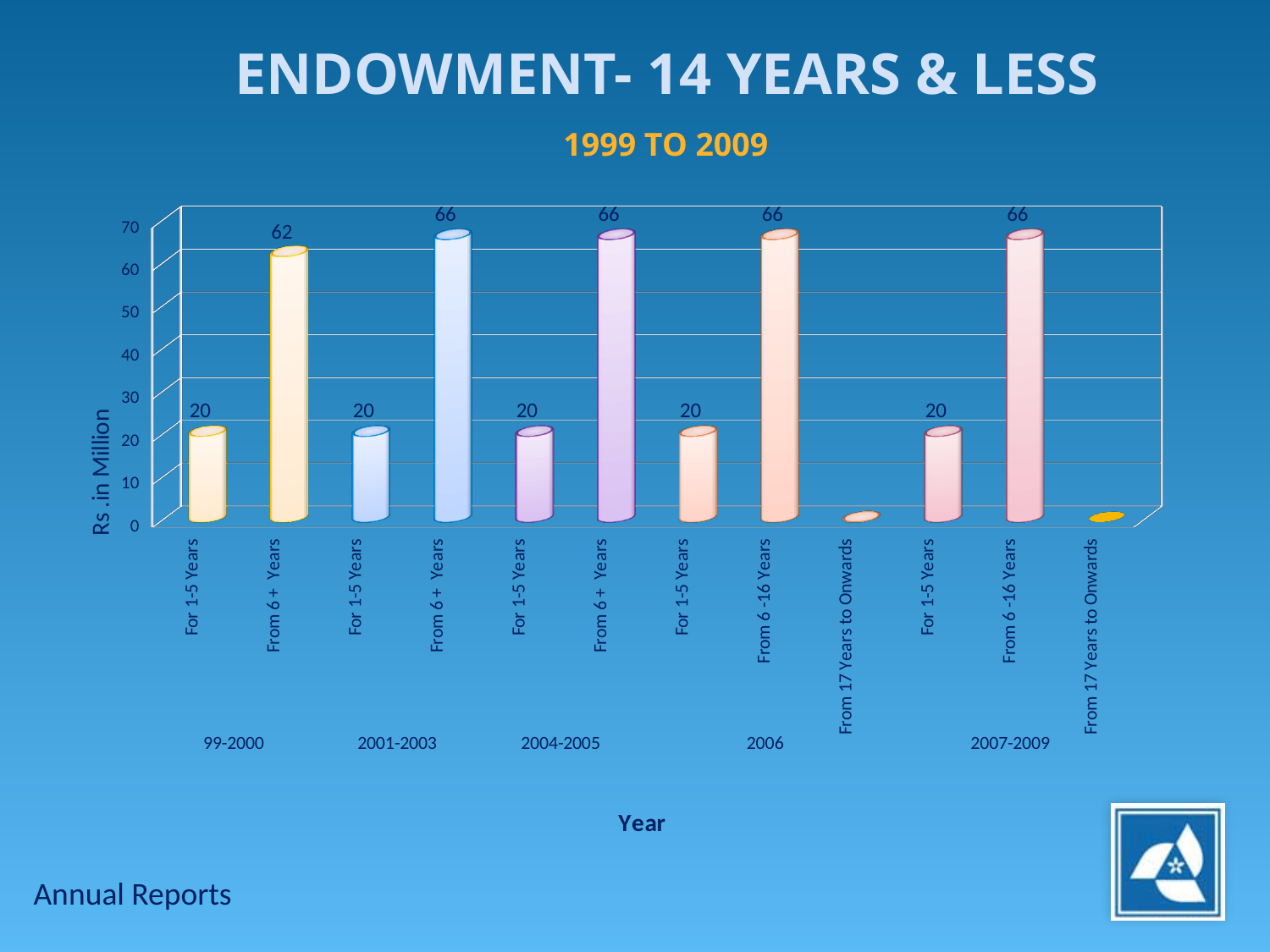
What is the value for 'For 1-5 Years' in 2001-2003? 20 How many bars are plotted on the chart? 12 What is the value for 'From 6 + Years' in 2004-2005? 66 Is the value for 'From 17 Years to Onwards' in 2006 greater or less than 10? less What is the value for 'From 6 + Years' in 99-2000? 62 Which is larger in 2001-2003: 'For 1-5 Years' or 'From 6 + Years'? From 6 + Years What kind of chart is shown on the slide? Bar chart What is the value for 'From 6 -16 Years' in 2007-2009? 66 What is the label of the vertical axis? Rs .in Million What is the difference between 'From 6 + Years' and 'For 1-5 Years' in 99-2000? 42 Which is larger: 'From 6 + Years' in 99-2000 or 'From 6 + Years' in 2001-2003? From 6 + Years in 2001-2003 What is the difference between 'From 6 -16 Years' and 'For 1-5 Years' in 2006? 46